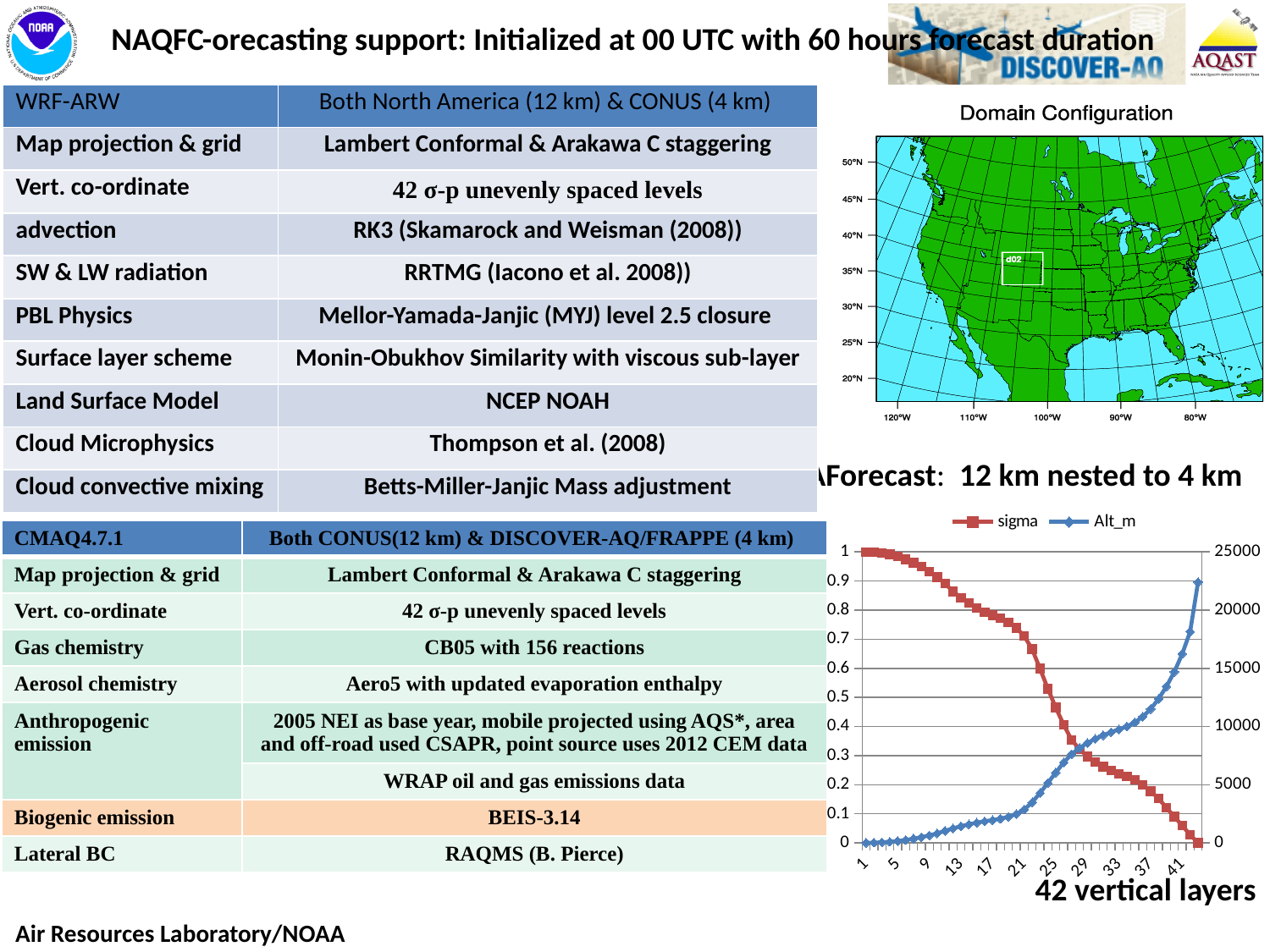
What is the highest value shown on the right-hand y axis of the bottom-right chart? 25000 What kind of chart is shown at the bottom right of the slide? line chart In the bottom-right chart, which is larger: the sigma value at layer 1 or the sigma value at layer 41? layer 1 In the bottom-right chart, does the Alt_m series rise or fall as the layer number increases along the x axis? rise In the bottom-right chart, what is the sigma value at layer 1? 1 In the bottom-right chart, is the sigma value at layer 25 greater or less than 0.7? less In the bottom-right chart, is the Alt_m value at layer 41 greater or less than 15000? greater In the bottom-right chart, does the sigma series rise or fall as the layer number increases along the x axis? fall In the bottom-right chart, is the Alt_m value at layer 21 greater or less than 5000? less How many series does the legend of the bottom-right chart list? 2 What are the two series named in the legend of the bottom-right chart? sigma and Alt_m